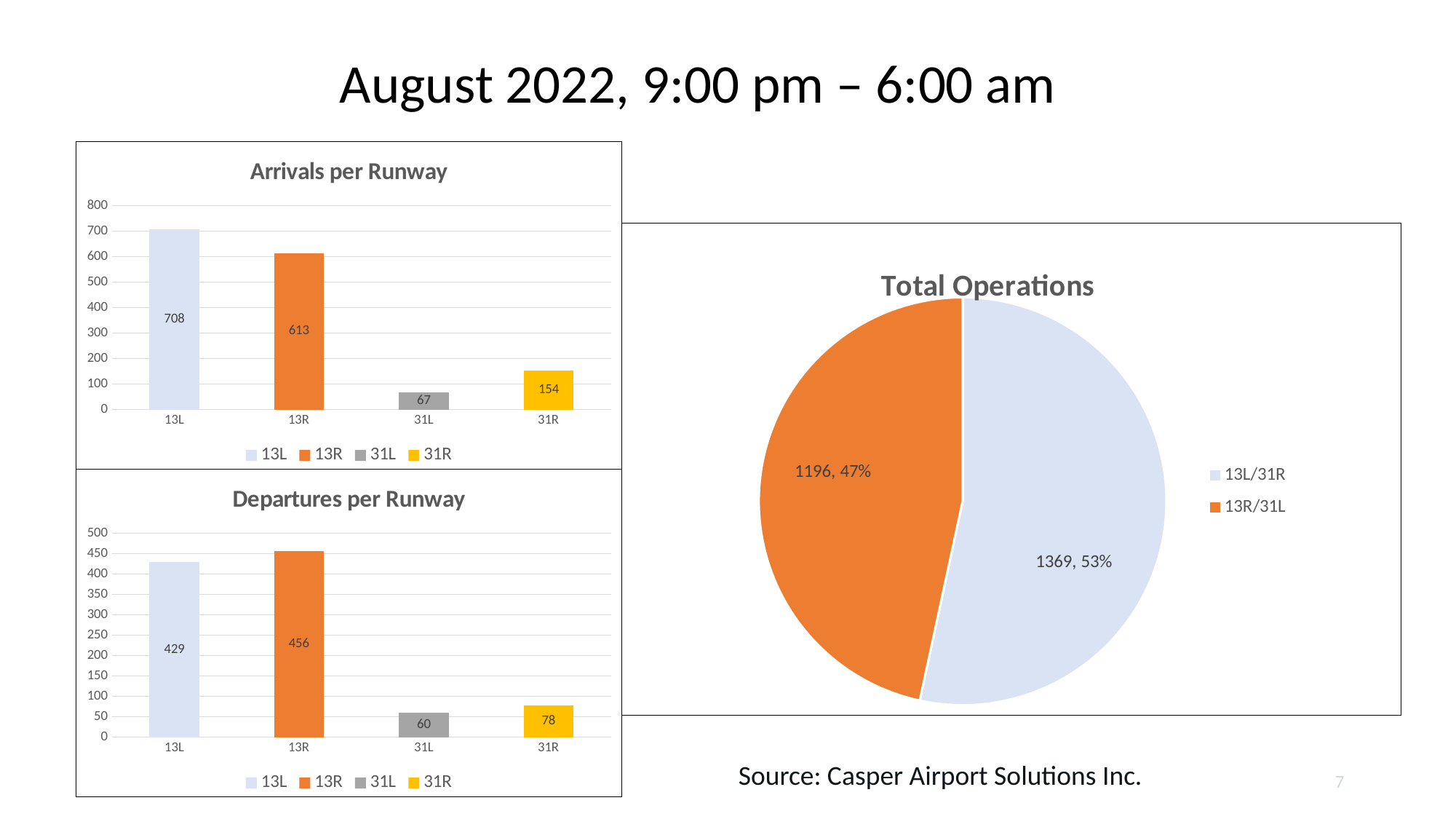
In the Arrivals per Runway chart, what is the difference between the values for 13L and 13R? 95 In the Departures per Runway chart, how many runways are shown on the x axis? 4 In the Arrivals per Runway chart, which runway has the lowest number of arrivals? 31L In the Total Operations pie chart, what share of the pie does 13L/31R represent? 53% In the Departures per Runway chart, what is the value for runway 13R? 456 In the Arrivals per Runway chart, what is the value for runway 13L? 708 How many entries does the legend of the Total Operations chart list? 2 In the Total Operations pie chart, what is the value for 13R/31L? 1196, 47% In the Departures per Runway chart, which runway has the highest number of departures? 13R What kind of chart is the Total Operations chart? pie chart What kind of chart is the Arrivals per Runway chart? bar chart In the Departures per Runway chart, which is larger, the value for 31L or the value for 31R? 31R